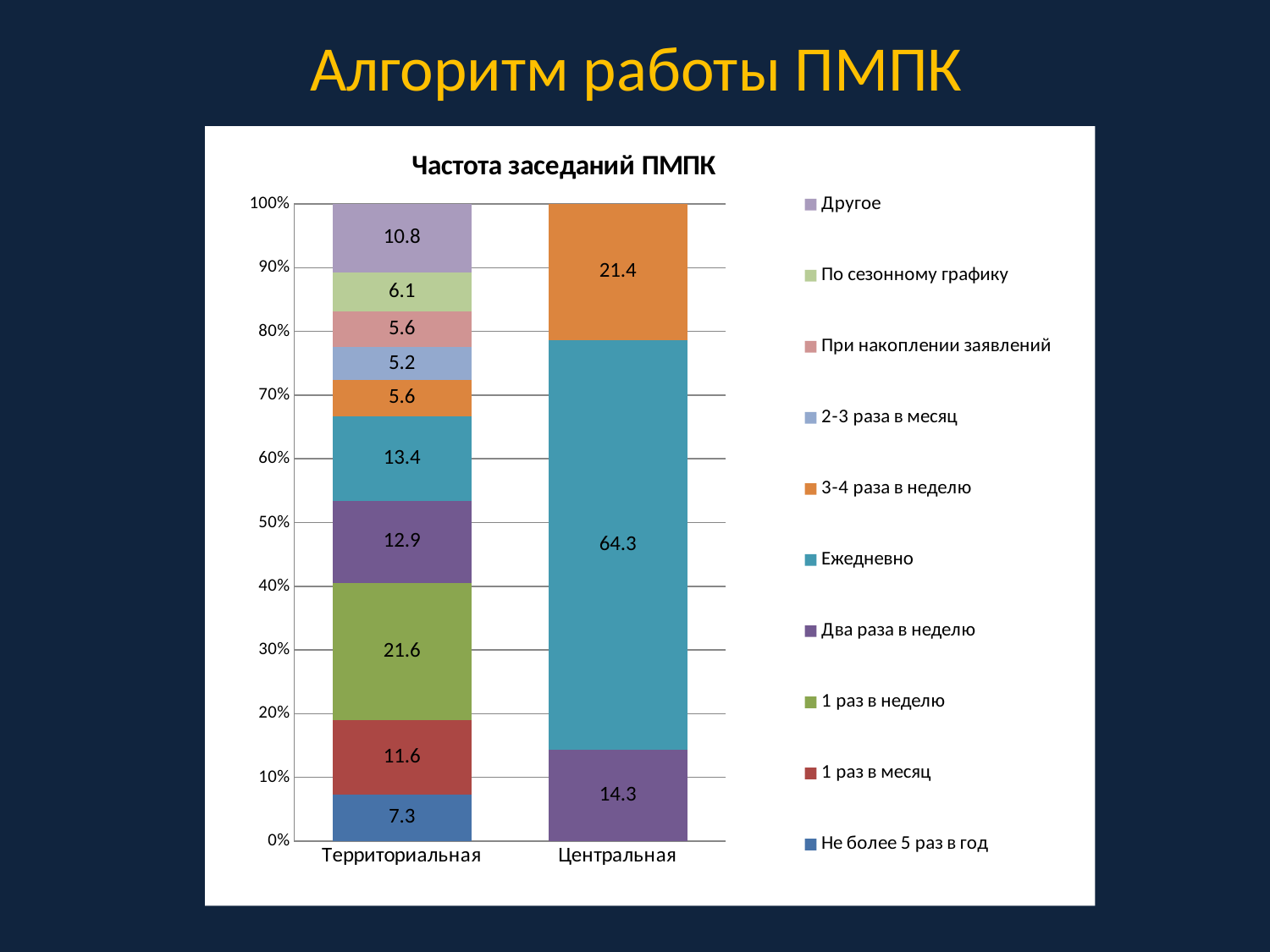
What is the title of the chart? Частота заседаний ПМПК Which segment is the largest in the Территориальная bar? 1 раз в неделю What is the difference between the Ежедневно values for Центральная and Территориальная? 50.9 What is the value for 1 раз в неделю in the Территориальная bar? 21.6 How many series does the legend list? 10 How many categories are shown on the x axis? 2 Which segment is the smallest in the Территориальная bar? 2-3 раза в месяц Which is larger in the Территориальная bar: Два раза в неделю or Ежедневно? Ежедневно What is the value for Не более 5 раз в год in the Территориальная bar? 7.3 What is the value for Ежедневно in the Центральная bar? 64.3 What is the value for 3-4 раза в неделю in the Центральная bar? 21.4 What kind of chart is shown on the slide? Stacked bar chart